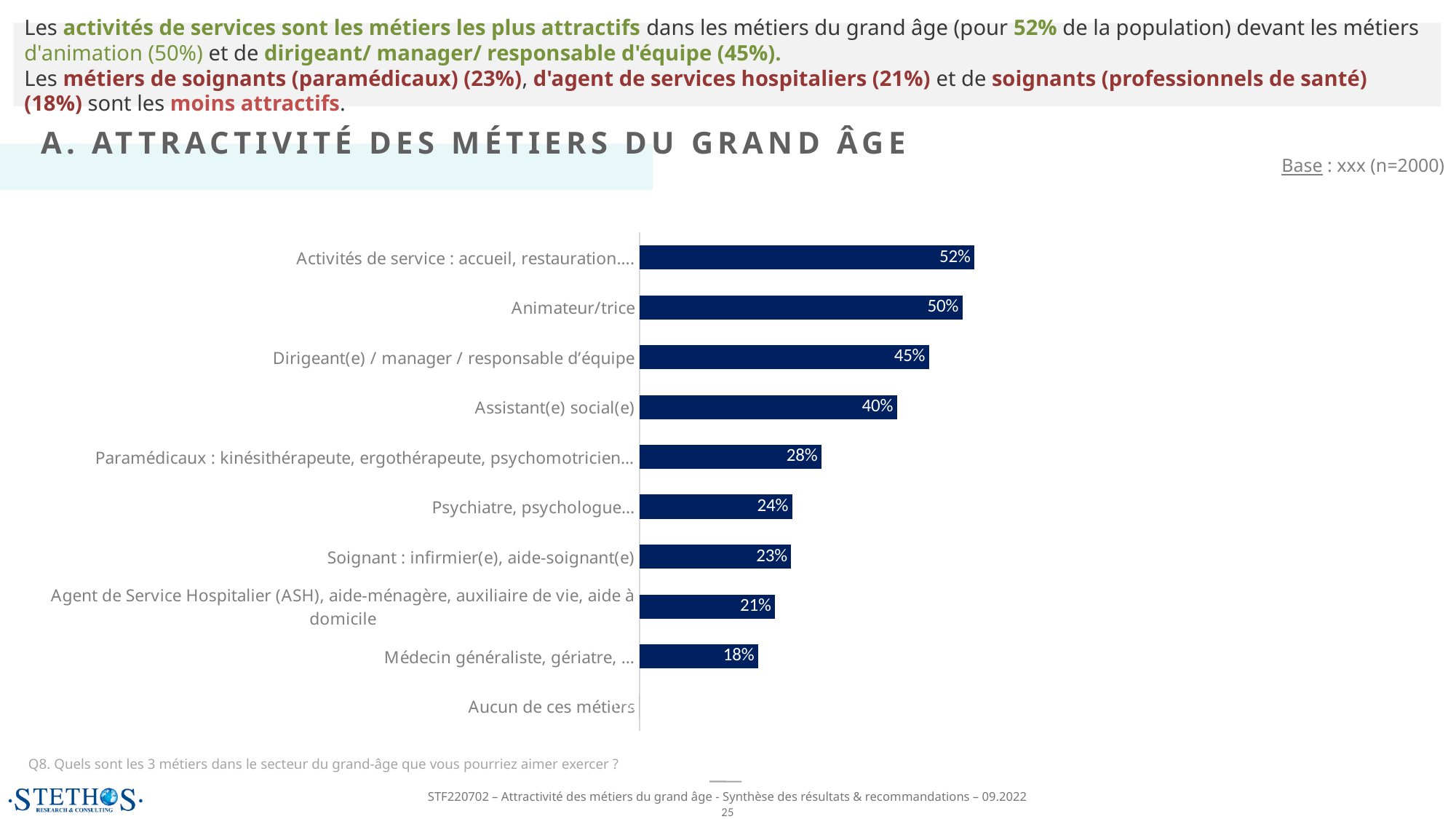
What is the value for Agent de Service Hospitalier (ASH), aide-ménagère, auxiliaire de vie, aide à domicile? 21% What is the difference between the values for Animateur/trice and Dirigeant(e) / manager / responsable d'équipe? 5 percentage points What is the value for Animateur/trice? 50% What is the value for Activités de service : accueil, restauration…? 52% What is the difference between the values for Activités de service : accueil, restauration… and Médecin généraliste, gériatre, …? 34 percentage points What is the value for Assistant(e) social(e)? 40% How many categories are listed on the chart's axis? 10 Which is larger, the value for Paramédicaux : kinésithérapeute, ergothérapeute, psychomotricien… or the value for Psychiatre, psychologue…? Paramédicaux : kinésithérapeute, ergothérapeute, psychomotricien… What is the value for Médecin généraliste, gériatre, …? 18% Which category has the highest value? Activités de service : accueil, restauration… What kind of chart is shown on the slide? Bar chart What is the title of the chart section on the slide? A. ATTRACTIVITÉ DES MÉTIERS DU GRAND ÂGE